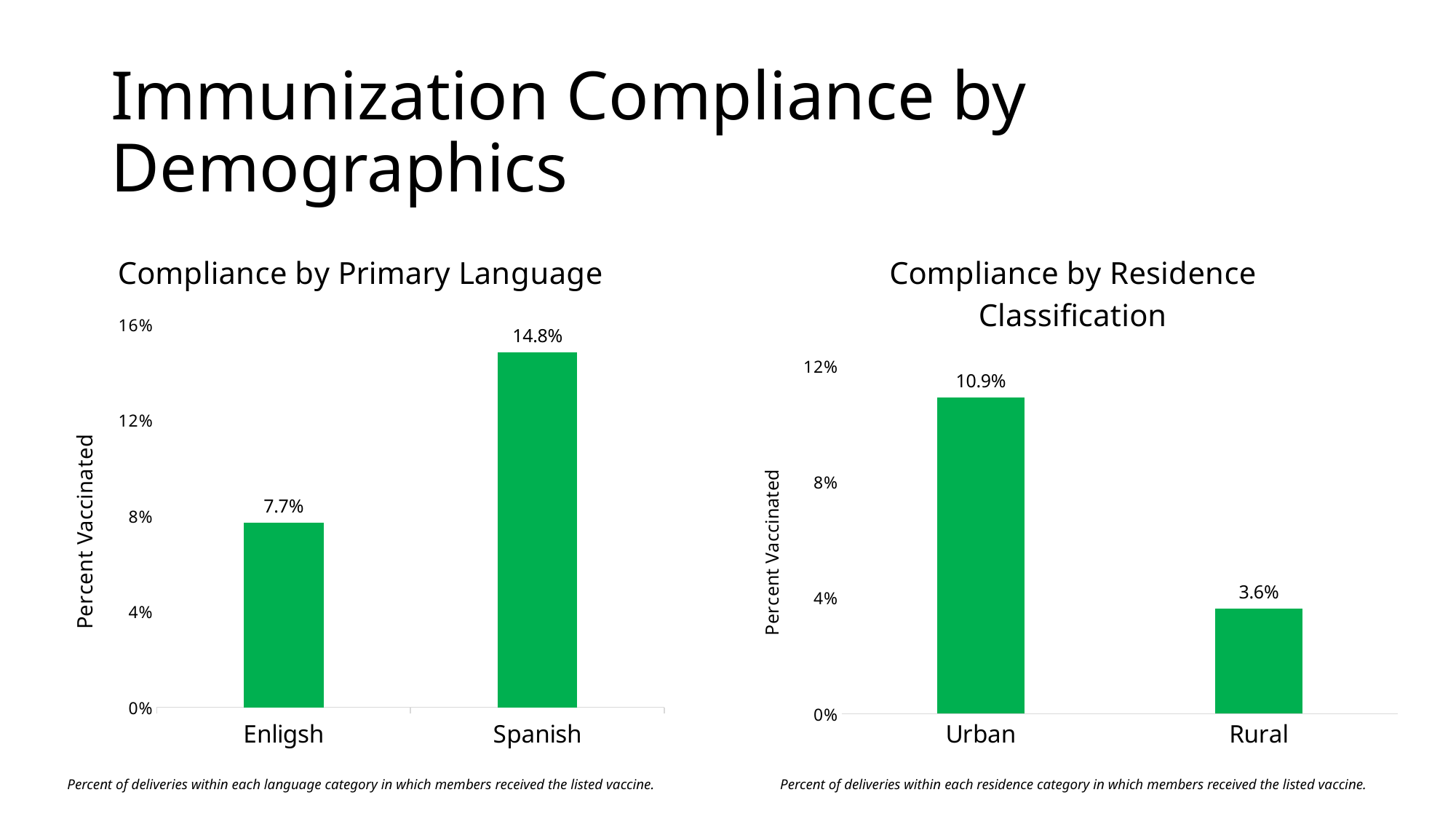
In the 'Compliance by Residence Classification' chart, what is the value for Urban? 10.9% How many categories are shown in the 'Compliance by Primary Language' chart? 2 In the 'Compliance by Residence Classification' chart, which category has the lowest value? Rural In the 'Compliance by Primary Language' chart, what is the difference between the Spanish and Enligsh values? 7.1% In the 'Compliance by Residence Classification' chart, is the value for Urban greater or less than 8%? greater In the 'Compliance by Primary Language' chart, which category has the highest value? Spanish In the 'Compliance by Primary Language' chart, what is the value for Enligsh? 7.7% In the 'Compliance by Residence Classification' chart, what is the difference between the Urban and Rural values? 7.3% In the 'Compliance by Primary Language' chart, what is the value for Spanish? 14.8% What kind of chart is the 'Compliance by Residence Classification' chart? bar chart What is the y-axis label of the 'Compliance by Primary Language' chart? Percent Vaccinated In the 'Compliance by Residence Classification' chart, what is the value for Rural? 3.6%